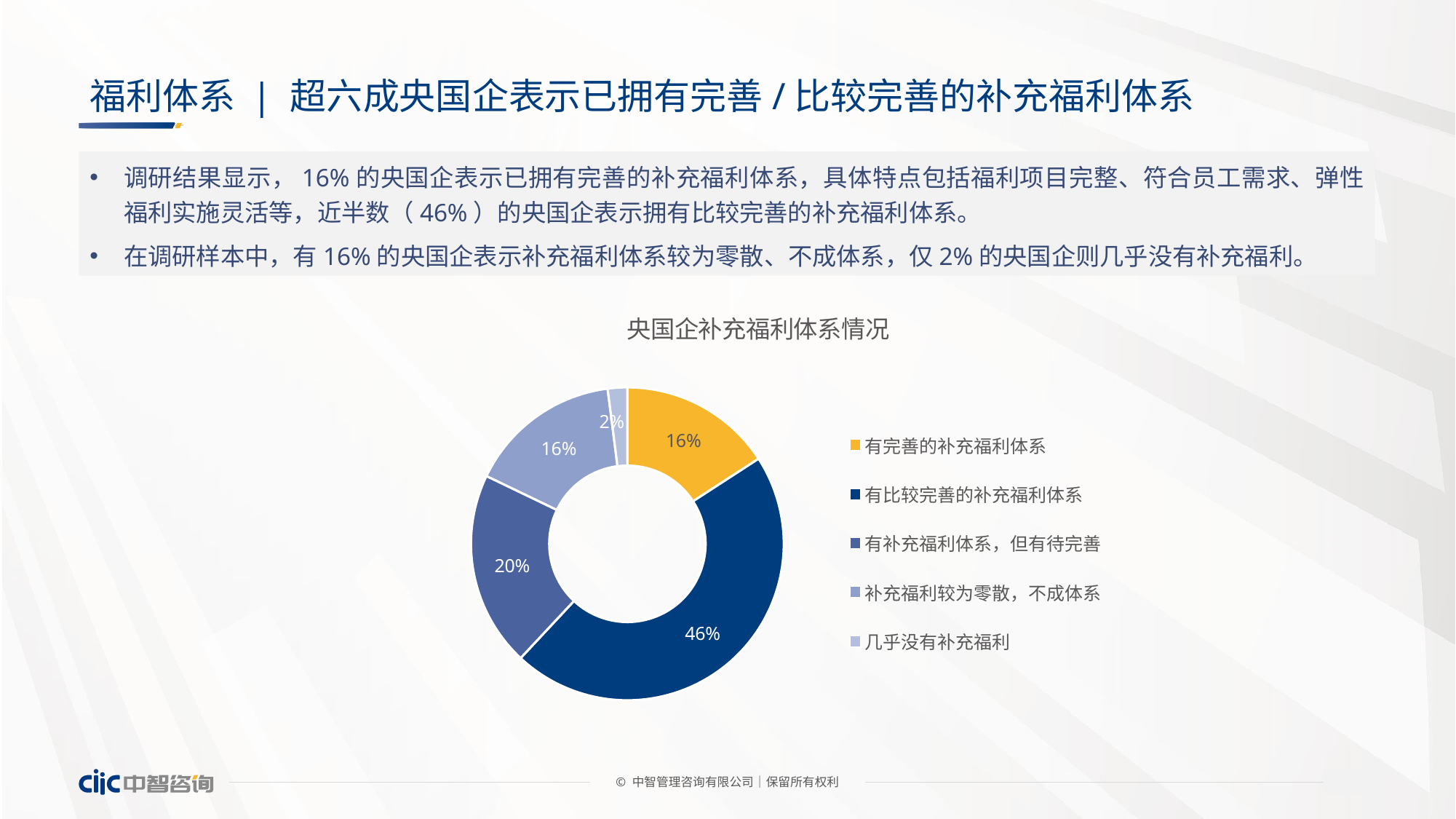
Which category has the largest share of the pie? 有比较完善的补充福利体系 What is the difference between the shares for 有比较完善的补充福利体系 and 有补充福利体系，但有待完善? 26% What share of the pie is labelled 有补充福利体系，但有待完善? 20% What share of the pie is labelled 有完善的补充福利体系? 16% What share of the pie is labelled 几乎没有补充福利? 2% What type of chart is shown on the slide? Pie chart (doughnut) What colour is the slice for 有完善的补充福利体系? Yellow Which is larger: the share for 有补充福利体系，但有待完善 or the share for 补充福利较为零散，不成体系? 有补充福利体系，但有待完善 How many categories does the legend list? 5 Which category has the smallest share of the pie? 几乎没有补充福利 What is the title of the chart? 央国企补充福利体系情况 What share of the pie is labelled 有比较完善的补充福利体系? 46%